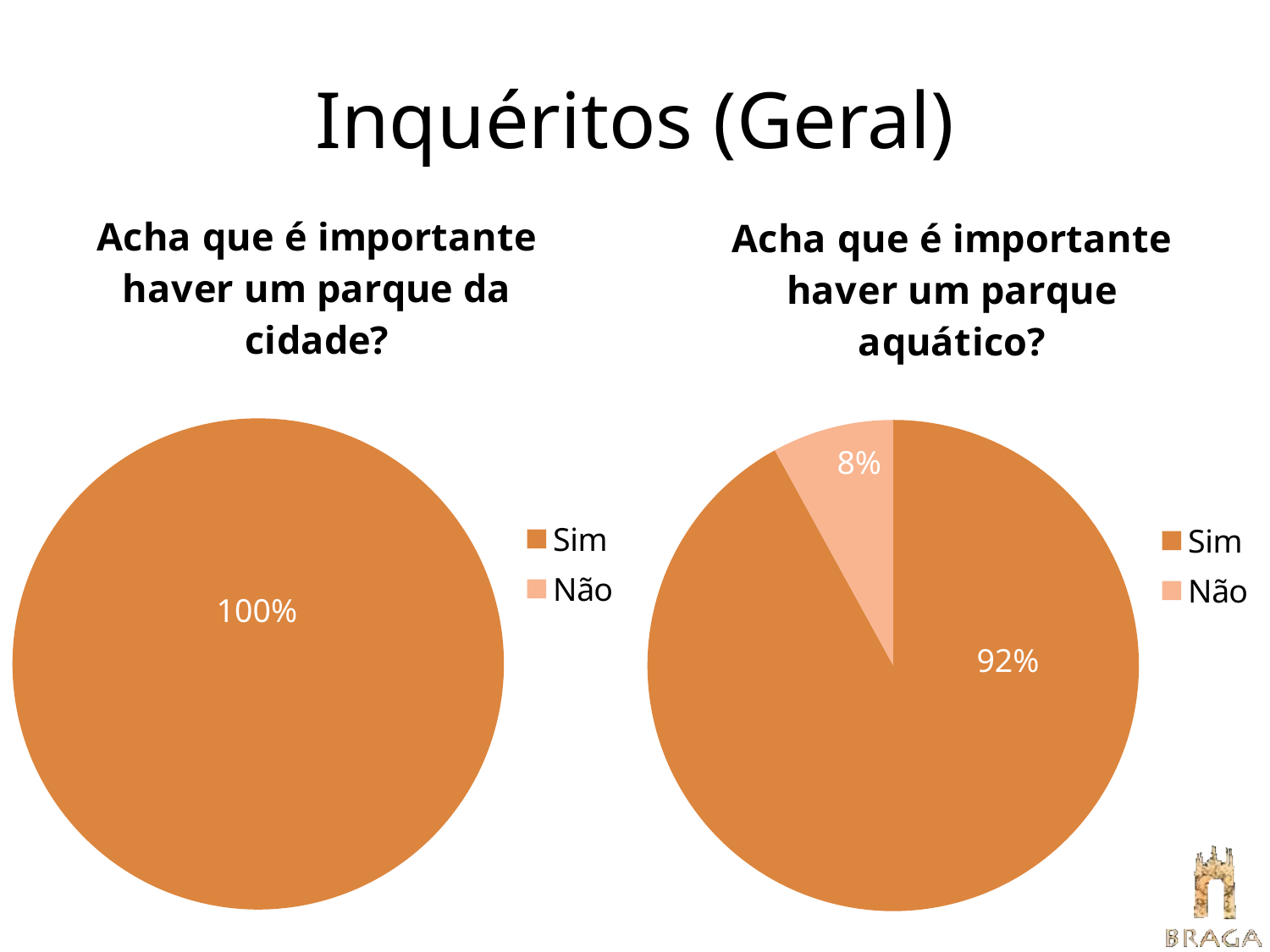
How many entries does the legend of the right chart 'Acha que é importante haver um parque aquático?' list? 2 In the right chart 'Acha que é importante haver um parque aquático?', what share of responses is 'Não'? 8% In the right chart 'Acha que é importante haver um parque aquático?', what is the difference between the 'Sim' and 'Não' shares? 84% What is the title of the left chart? Acha que é importante haver um parque da cidade? In the right chart 'Acha que é importante haver um parque aquático?', which response has the largest slice? Sim What kind of chart is the left chart 'Acha que é importante haver um parque da cidade?'? Pie chart In the right chart 'Acha que é importante haver um parque aquático?', what share of responses is 'Sim'? 92% How many visible slices does the right chart 'Acha que é importante haver um parque aquático?' have? 2 In the right chart 'Acha que é importante haver um parque aquático?', which is larger, 'Sim' or 'Não'? Sim In the left chart 'Acha que é importante haver um parque da cidade?', what share of responses is 'Sim'? 100% What kind of chart is the right chart 'Acha que é importante haver um parque aquático?'? Pie chart In the right chart 'Acha que é importante haver um parque aquático?', which response has the smallest slice? Não